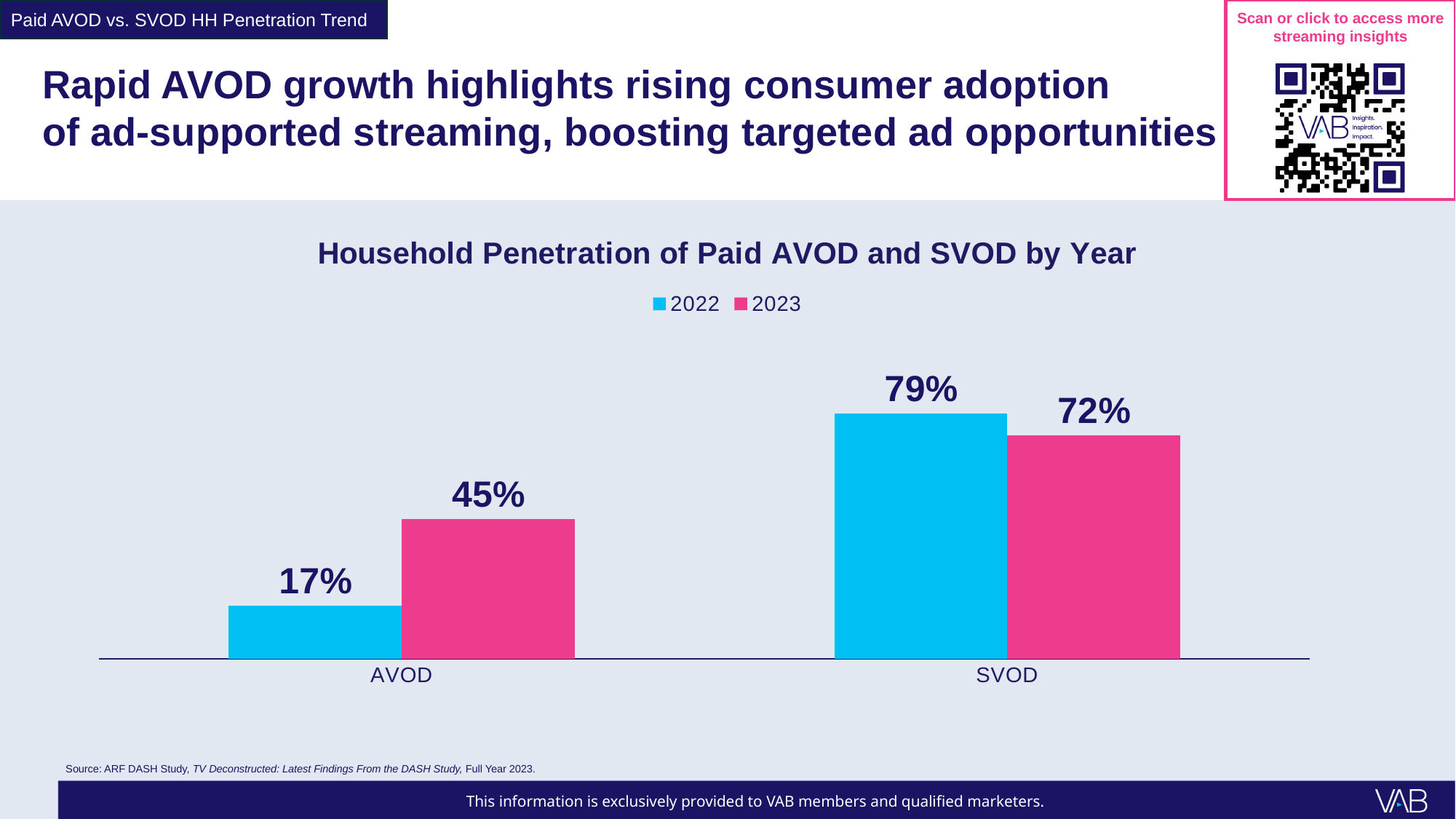
By how many percentage points did AVOD household penetration change from 2022 to 2023? 28 percentage points What is the household penetration of SVOD in 2023? 72% Which bar shows the lowest value on the chart? AVOD 2022 What is the household penetration of AVOD in 2023? 45% What is the household penetration of SVOD in 2022? 79% By how many percentage points did SVOD household penetration change from 2022 to 2023? 7 percentage points What is the title of the chart? Household Penetration of Paid AVOD and SVOD by Year How many series does the legend list? 2 What kind of chart is shown on the slide? Bar chart Which is larger: SVOD penetration in 2023 or AVOD penetration in 2023? SVOD penetration in 2023 What is the household penetration of AVOD in 2022? 17% Which bar shows the highest value on the chart? SVOD 2022